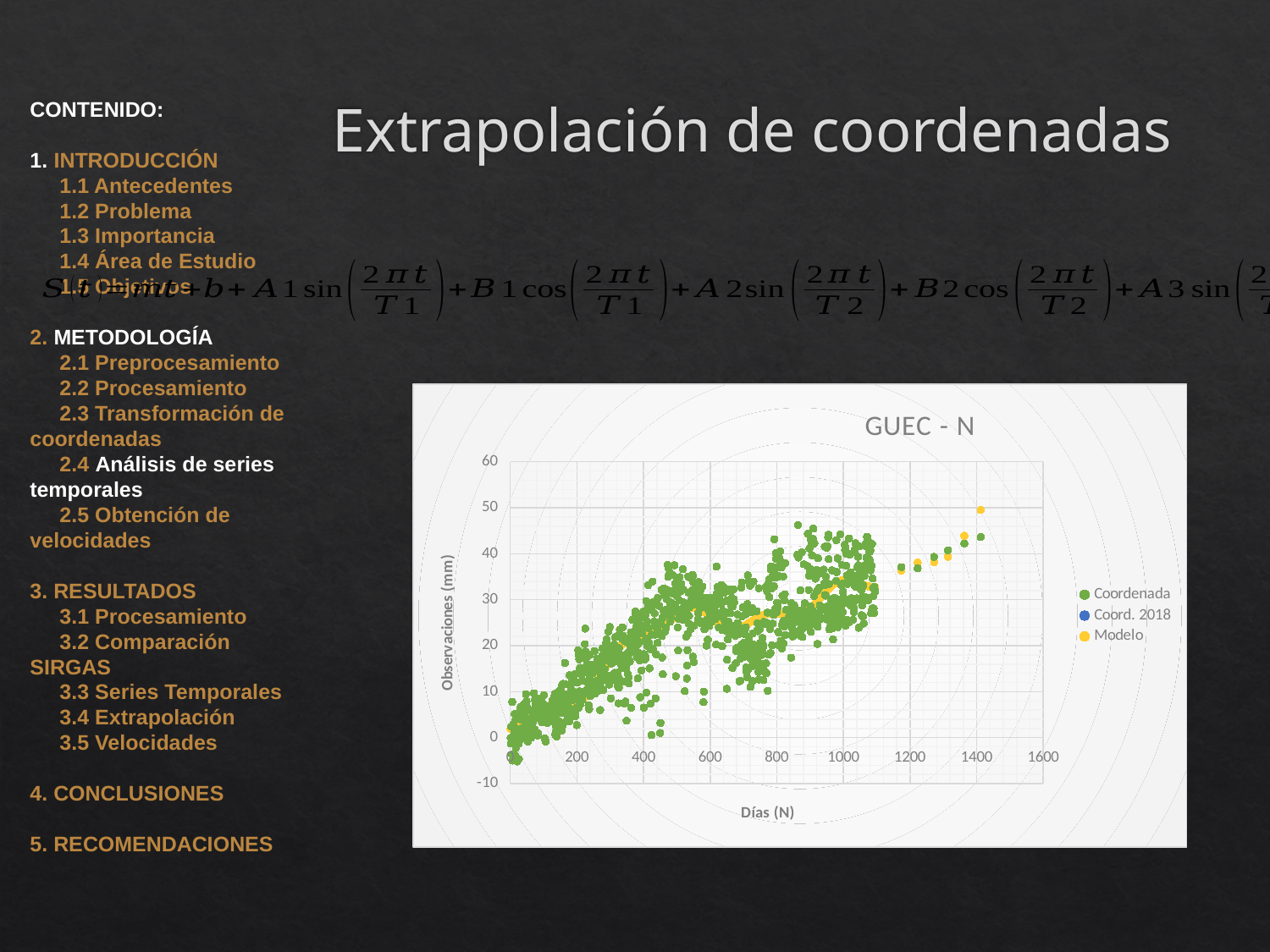
How many series does the chart legend list? 3 Are the observation values plotted near day 100 greater or less than 10 mm? less Are the observation values plotted near day 200 greater or less than 20 mm? less Are the observation values plotted near day 1200 greater or less than 30 mm? greater Do the observations generally rise or fall as the number of days increases along the x axis? Rise What is the title of the chart? GUEC - N What are the three series named in the chart legend? Coordenada, Coord. 2018, Modelo What kind of chart is shown on the slide? Scatter chart